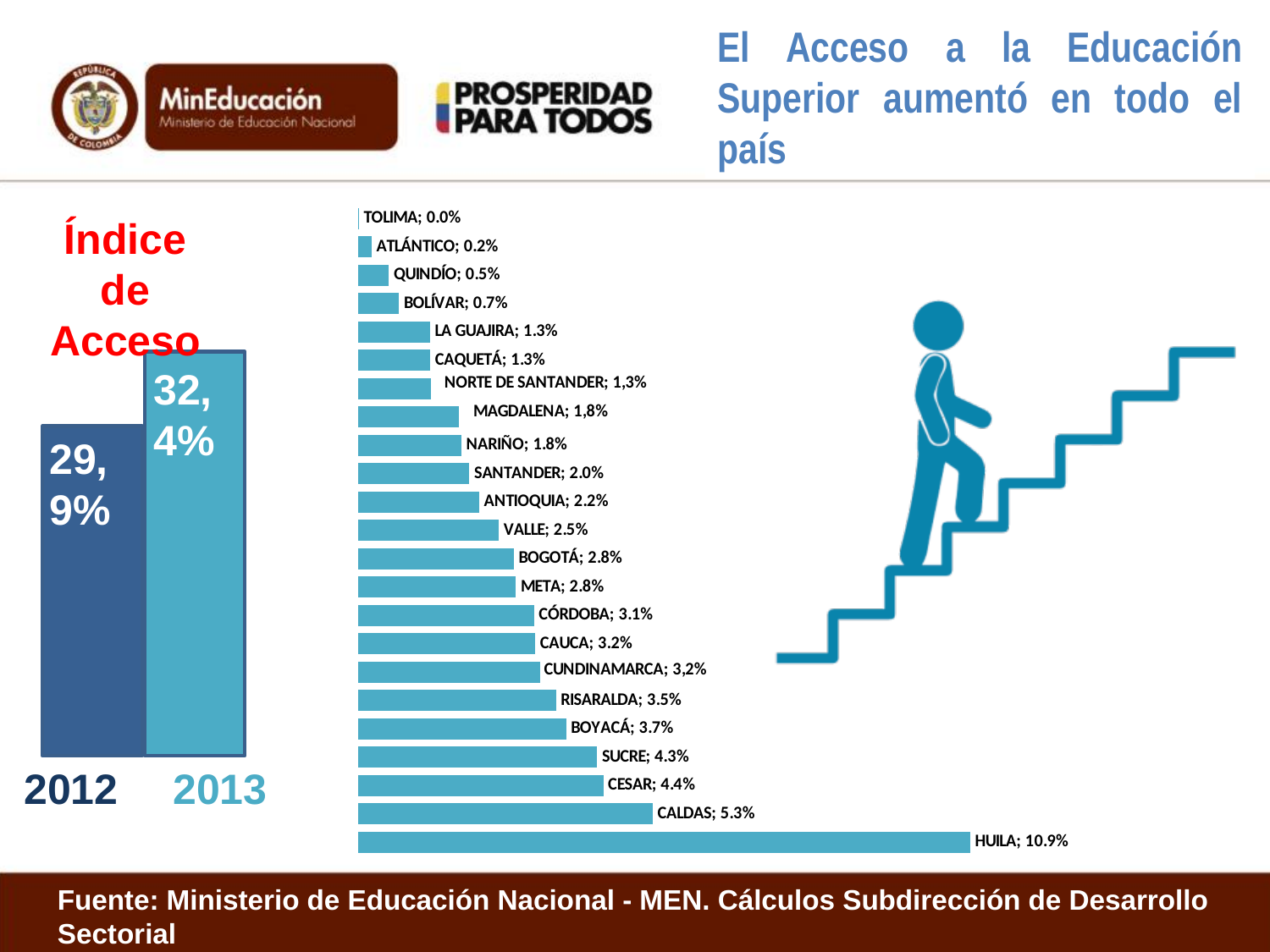
In the right chart of departments, which department has the lowest value? TOLIMA In the left chart titled 'Índice de Acceso', what is the value for 2012? 29,9% In the right chart of departments, which has the larger value, SUCRE or BOYACÁ? SUCRE In the right chart of departments, what is the value for CUNDINAMARCA? 3,2% In the right chart of departments, which department has the highest value? HUILA What kind of chart is the right chart of departments? bar chart In the left chart titled 'Índice de Acceso', by how much did the value increase from 2012 to 2013? 2,5% In the left chart titled 'Índice de Acceso', what is the value for 2013? 32,4% In the left chart titled 'Índice de Acceso', does the value rise or fall from 2012 to 2013? rise In the right chart of departments, what is the value for CALDAS? 5.3% In the right chart of departments, how many departments are shown? 23 In the right chart of departments, what is the difference between the values for HUILA and CALDAS? 5.6%